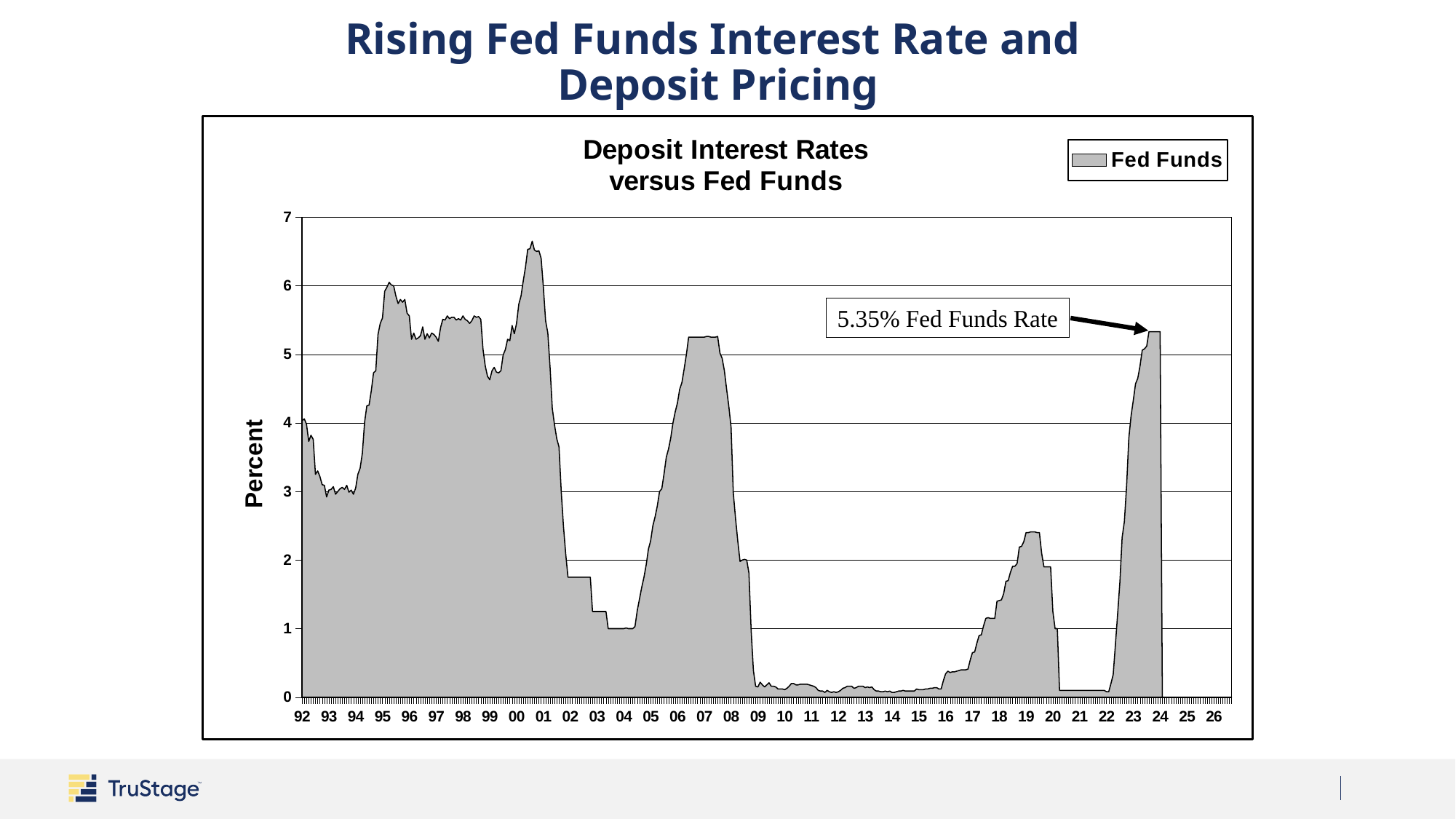
Is the Fed Funds value at 12 greater or less than 1? less Is the Fed Funds value at 21 greater or less than 1? less Which is larger, the Fed Funds value at 07 or at 19? 07 What kind of chart is shown on the slide? area chart How many series does the legend list? 1 What is the Fed Funds rate called out by the annotation near 2024? 5.35% What is the title of the chart? Deposit Interest Rates versus Fed Funds Does the Fed Funds rate rise or fall from 22 to 24? rise What is the label on the vertical axis? Percent Is the Fed Funds value at 19 greater or less than 2? greater Does the Fed Funds rate rise or fall from 07 to 09? fall